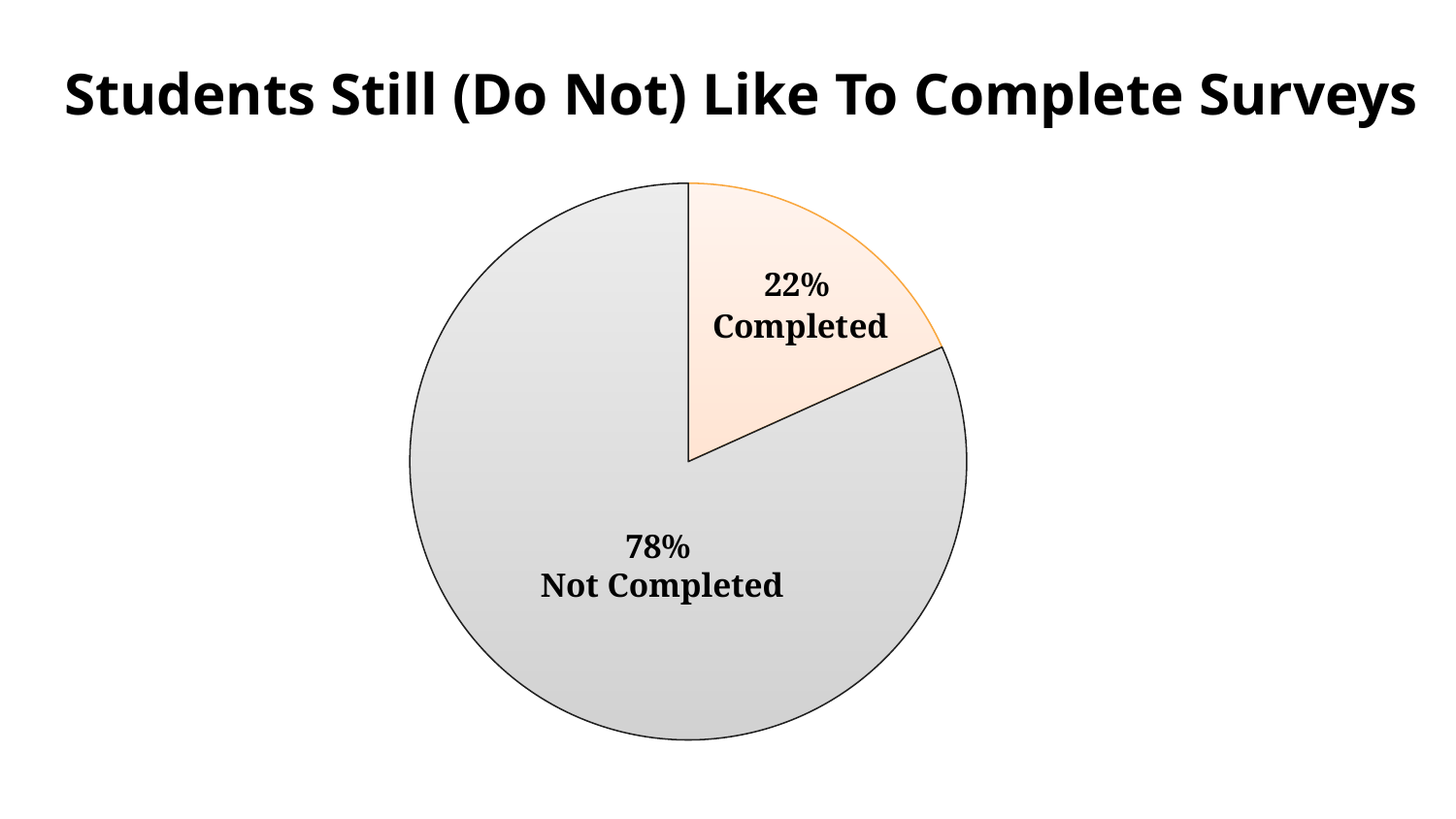
What is the difference in percentage points between the Not Completed and Completed slices? 56 Do the two slices add up to 100%? Yes What is the title of the slide? Students Still (Do Not) Like To Complete Surveys What kind of chart is shown on the slide? Pie chart What share of the pie does the Completed slice represent? 22% Which slice is shaded orange? Completed What percentage of students completed the survey? 22% Which is larger, the Completed slice or the Not Completed slice? Not Completed Which slice of the pie is the smallest? Completed What percentage of students did not complete the survey? 78% How many slices does the pie chart have? 2 Which slice of the pie is the largest? Not Completed